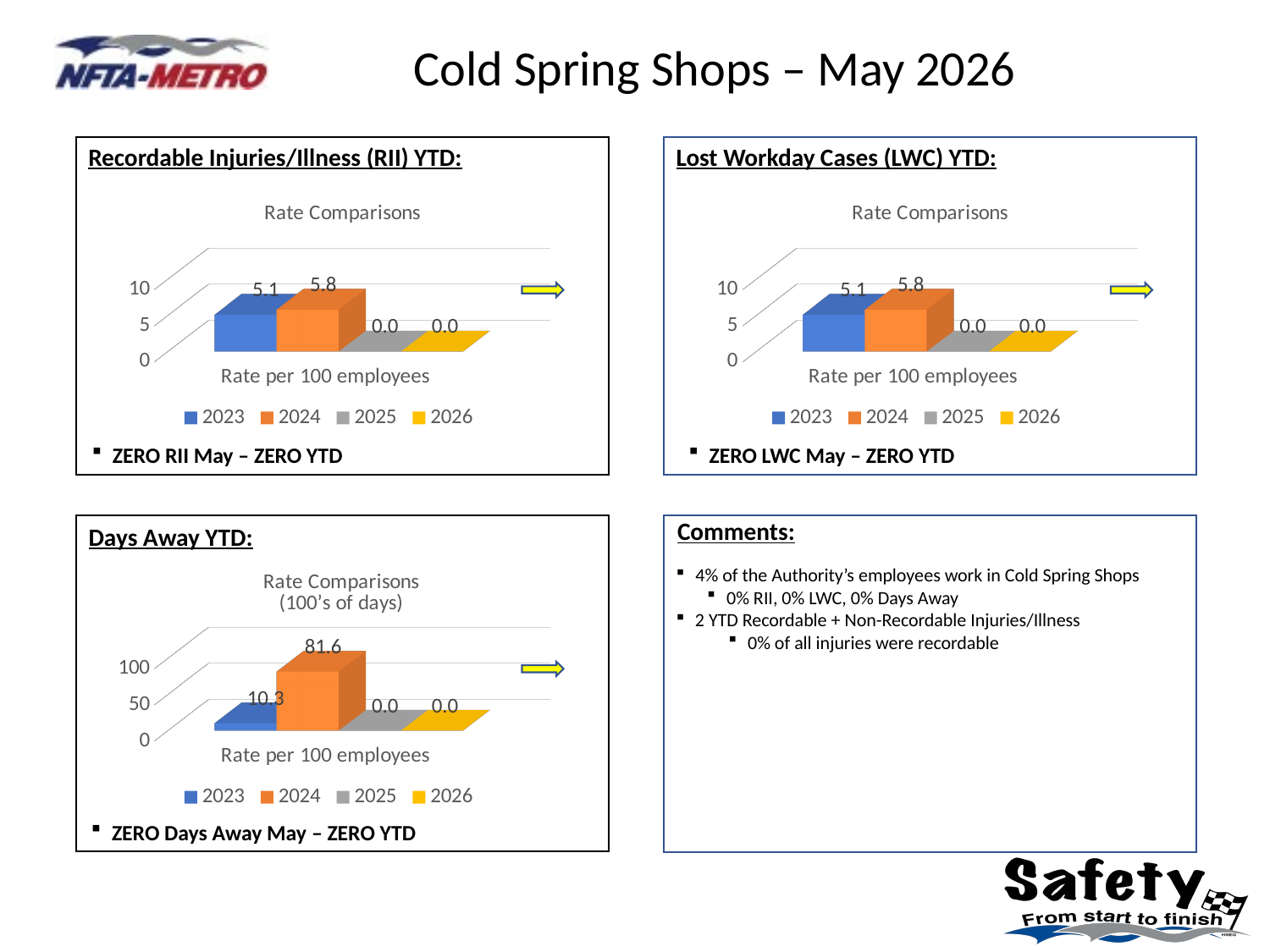
In the Days Away YTD chart, what is the value for 2023? 10.3 In the Lost Workday Cases (LWC) YTD chart, how many series does the legend list? 4 In the Days Away YTD chart, what is the value for 2024? 81.6 In the Days Away YTD chart, what is the difference between the 2024 and 2023 values? 71.3 In the Recordable Injuries/Illness (RII) YTD chart, what is the value for 2023? 5.1 In the Recordable Injuries/Illness (RII) YTD chart, what is the value for 2024? 5.8 In the Days Away YTD chart, which is larger, the value for 2023 or the value for 2024? 2024 In the Recordable Injuries/Illness (RII) YTD chart, what is the difference between the 2024 and 2023 values? 0.7 In the Lost Workday Cases (LWC) YTD chart, what is the value for 2026? 0.0 In the Lost Workday Cases (LWC) YTD chart, what is the value for 2023? 5.1 What kind of chart is the Days Away YTD chart? Bar chart In the Recordable Injuries/Illness (RII) YTD chart, which year has the highest value? 2024